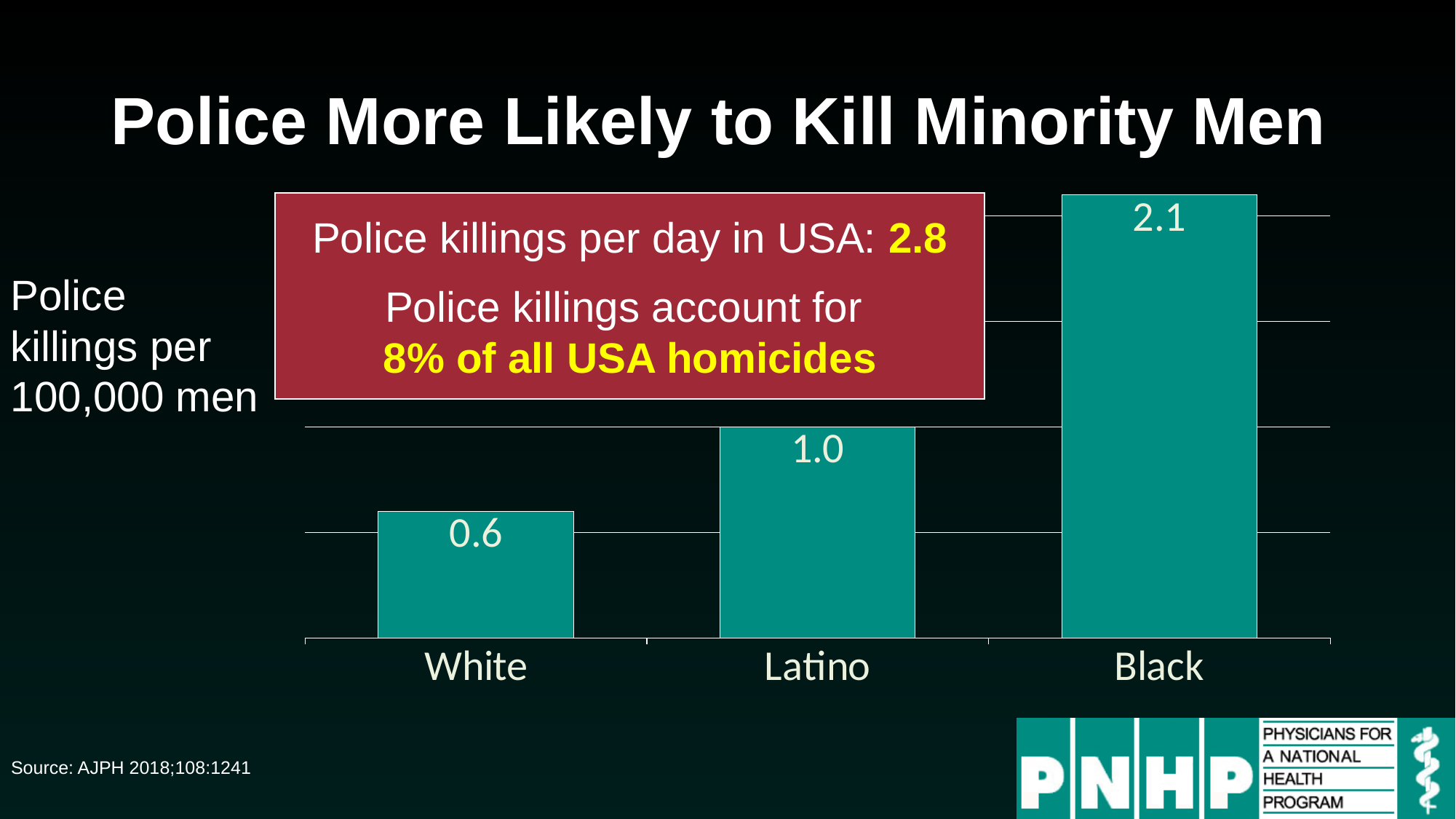
What is the value of police killings per 100,000 men for Black men? 2.1 What is the title of the slide containing the chart? Police More Likely to Kill Minority Men How many categories are shown in the bar chart? 3 What is the difference between the police killing rates for Latino men and White men? 0.4 Which category has the lowest rate of police killings per 100,000 men? White What is the value of police killings per 100,000 men for White men? 0.6 What kind of chart is shown on the slide? Bar chart Which is larger, the police killing rate for Latino men or for White men? Latino Do the values rise or fall moving from White to Black along the x axis? Rise Which category has the highest rate of police killings per 100,000 men? Black What is the difference between the police killing rates for Black men and White men? 1.5 What is the value of police killings per 100,000 men for Latino men? 1.0